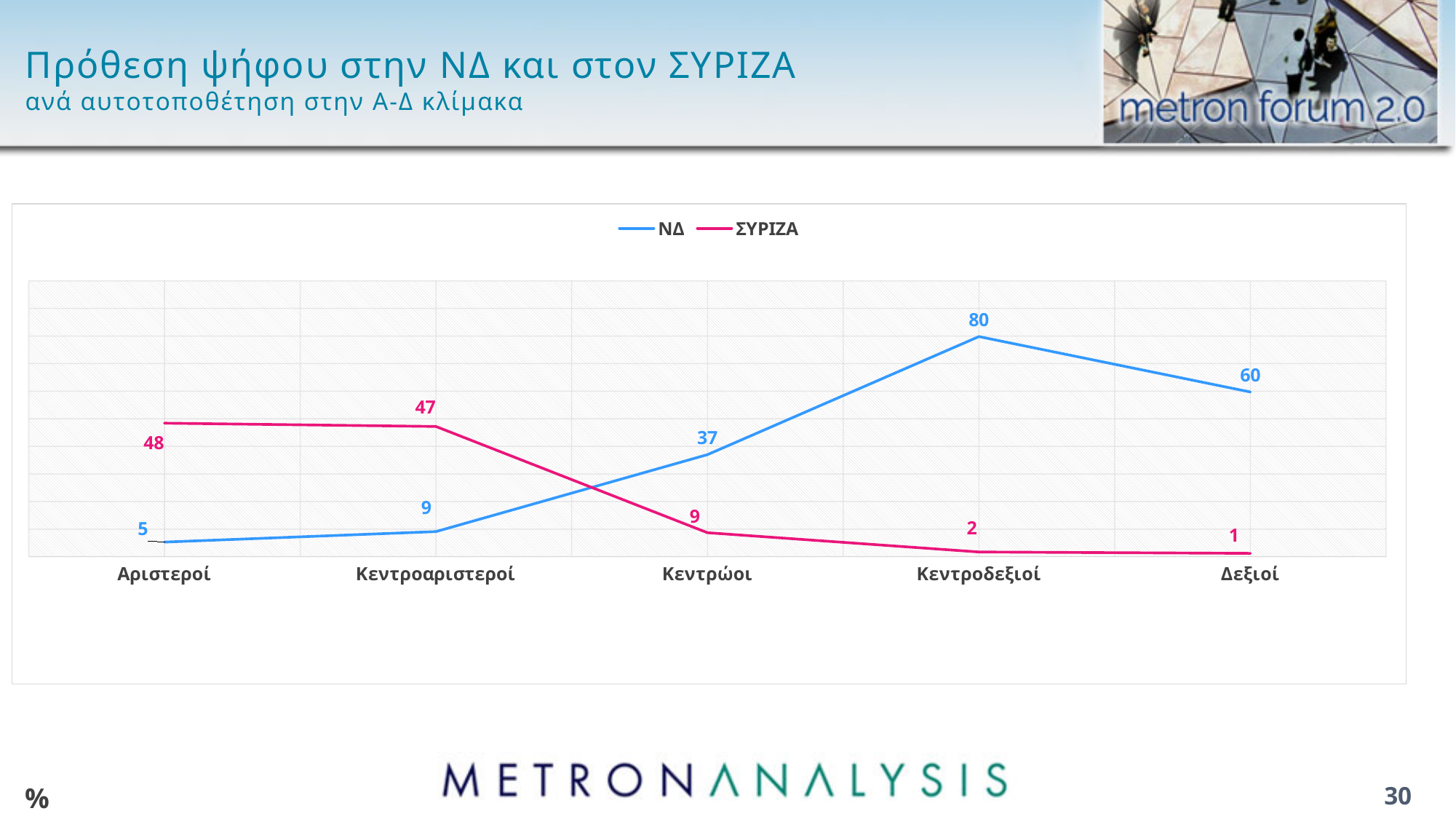
Which category has the highest value for ΝΔ? Κεντροδεξιοί What is the value for ΣΥΡΙΖΑ among Δεξιοί? 1 What is the value for ΣΥΡΙΖΑ among Αριστεροί? 48 What is the difference between the ΝΔ and ΣΥΡΙΖΑ values among Κεντροαριστεροί? 38 Which category has the lowest value for ΣΥΡΙΖΑ? Δεξιοί How many series does the legend list? 2 What is the value for ΝΔ among Κεντρώοι? 37 Does the ΣΥΡΙΖΑ line generally rise or fall from Αριστεροί to Δεξιοί? fall Among Κεντρώοι, which series has the larger value, ΝΔ or ΣΥΡΙΖΑ? ΝΔ What is the value for ΝΔ among Κεντροδεξιοί? 80 How many categories are shown on the x axis? 5 What kind of chart is shown on the slide? line chart